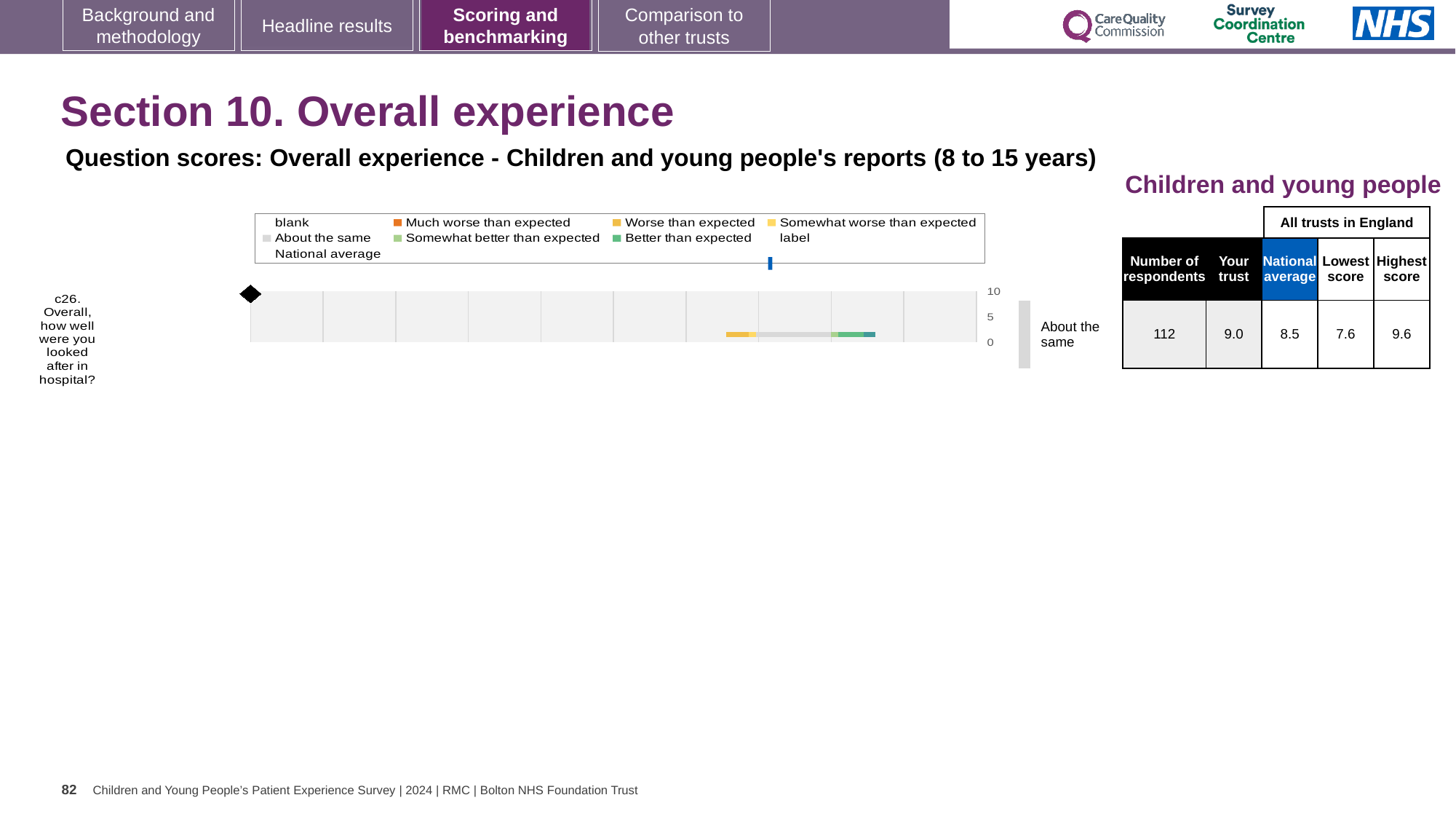
How many survey questions are plotted in the chart? 1 What is the lowest score among all trusts in England for question c26? 7.6 What is the 'Your trust' score for question c26 in the table? 9.0 What is the difference between the highest and lowest scores among all trusts for question c26? 2.0 How many respondents answered question c26? 112 Which is larger for question c26: the 'Your trust' score or the national average? Your trust What kind of chart is used to show the question score for c26? bar chart What is the difference between the 'Your trust' score and the national average for question c26? 0.5 What is the highest score among all trusts in England for question c26? 9.6 Which benchmark category is shown next to the bar for question c26? About the same What is the highest value shown on the chart's score axis? 10 What is the national average score for question c26? 8.5